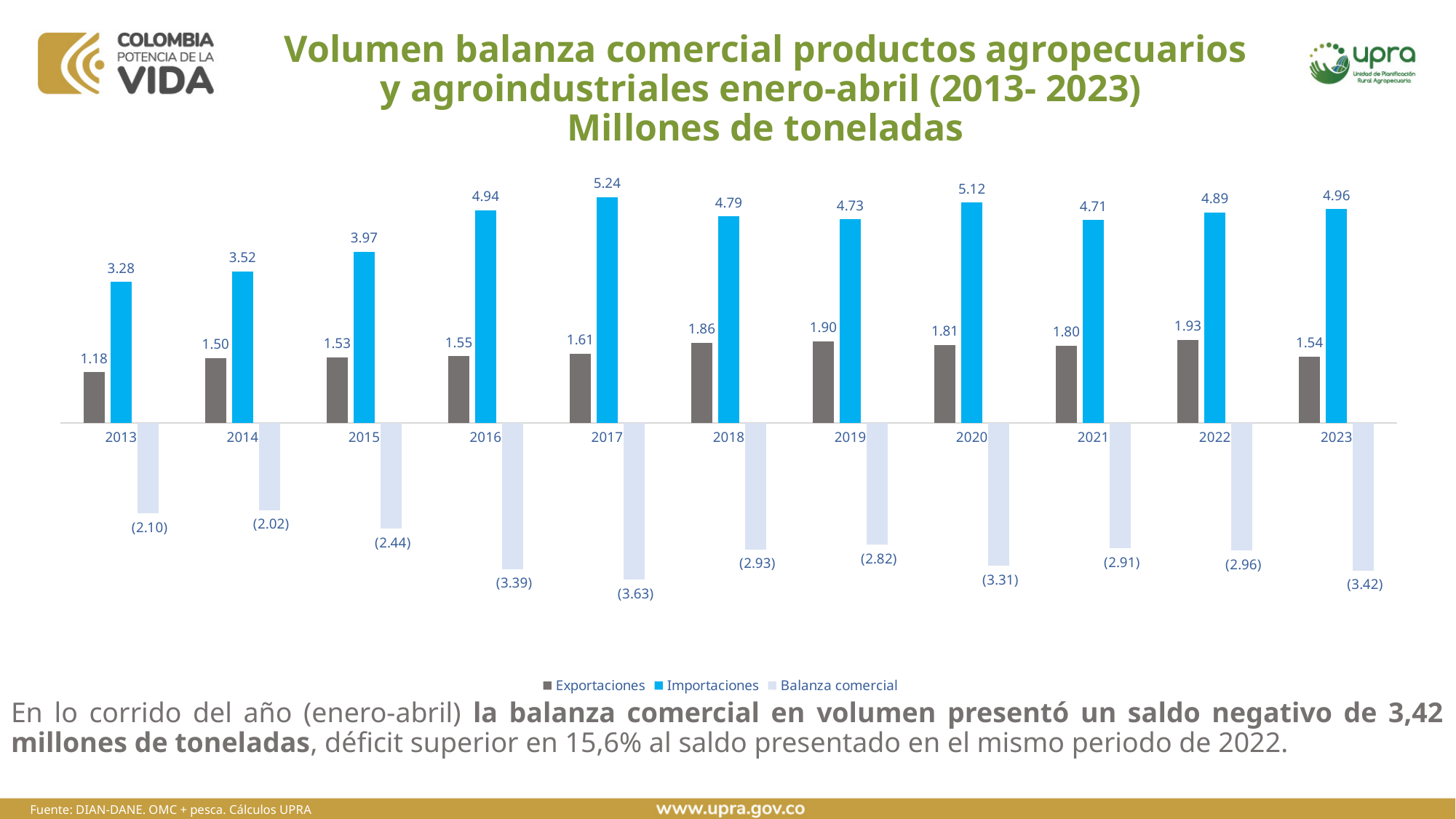
What is the value of Exportaciones for 2022? 1.93 How many series does the legend list? 3 What is the value of Importaciones for 2017? 5.24 Which is larger, Importaciones in 2020 or Importaciones in 2021? 2020 What is the difference between Importaciones and Exportaciones in 2023? 3.42 Do the Importaciones values rise or fall from 2013 to 2017? Rise What are the three series listed in the legend? Exportaciones, Importaciones, Balanza comercial In which year is Exportaciones lowest? 2013 What is the value of Balanza comercial for 2016? (3.39) In which year is Importaciones highest? 2017 What kind of chart is shown on the slide? Bar chart How many years are shown on the x axis? 11